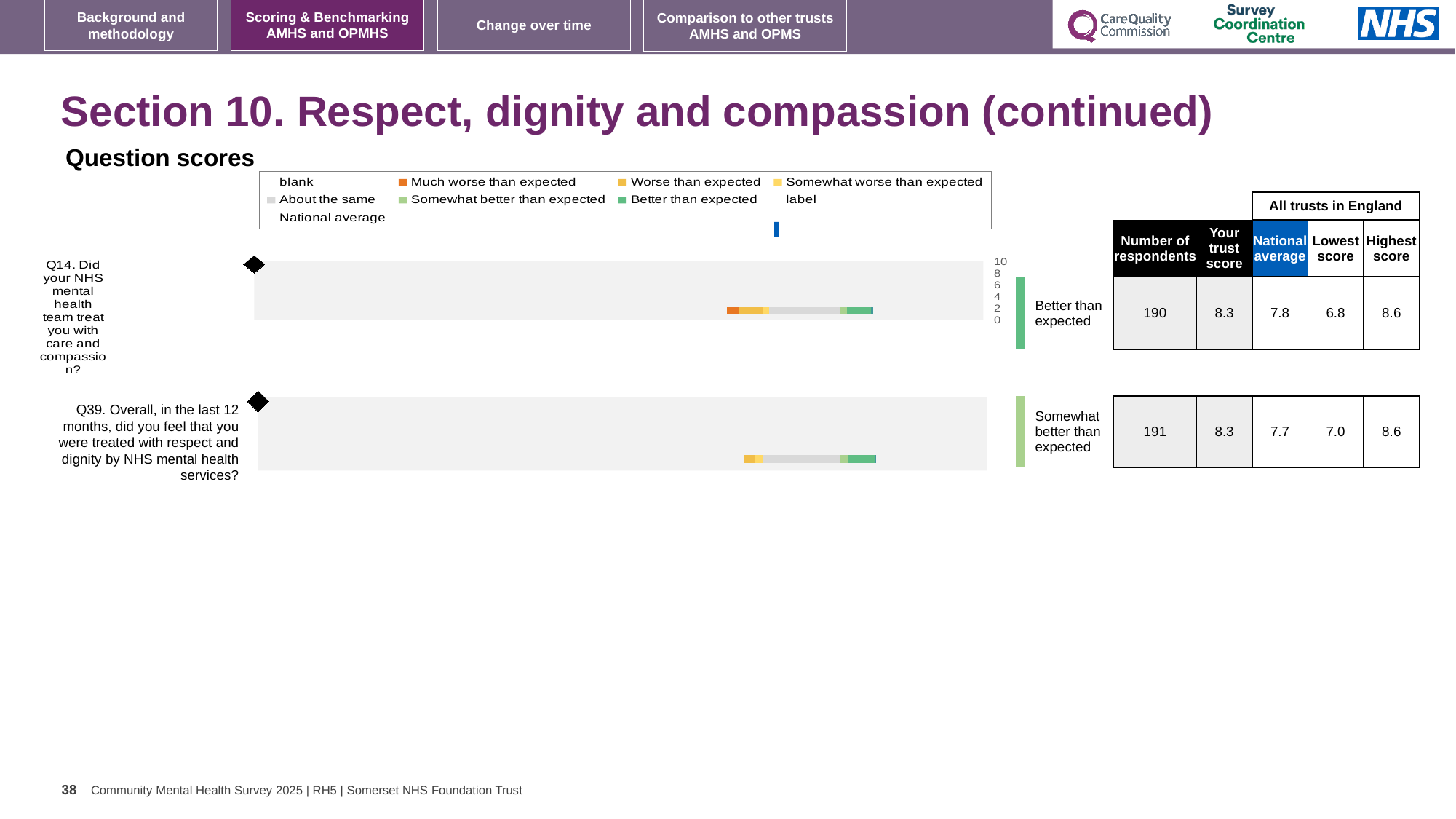
Which benchmark category is Q39 placed in? Somewhat better than expected What is the national average for Q39 (treated with respect and dignity)? 7.7 How many respondents answered Q39? 191 What is the highest score across all trusts in England for Q39? 8.6 What colour represents 'Better than expected' in the legend? green What is the lowest score across all trusts in England for Q14? 6.8 What is the trust score for Q14 (care and compassion)? 8.3 Which question has the higher national average, Q14 or Q39? Q14 How many questions are plotted in the question scores chart? 2 Which benchmark category is Q14 placed in? Better than expected By how much does the trust score for Q14 exceed the national average for Q14? 0.5 What kind of chart is used to show the question scores on this slide? bar chart